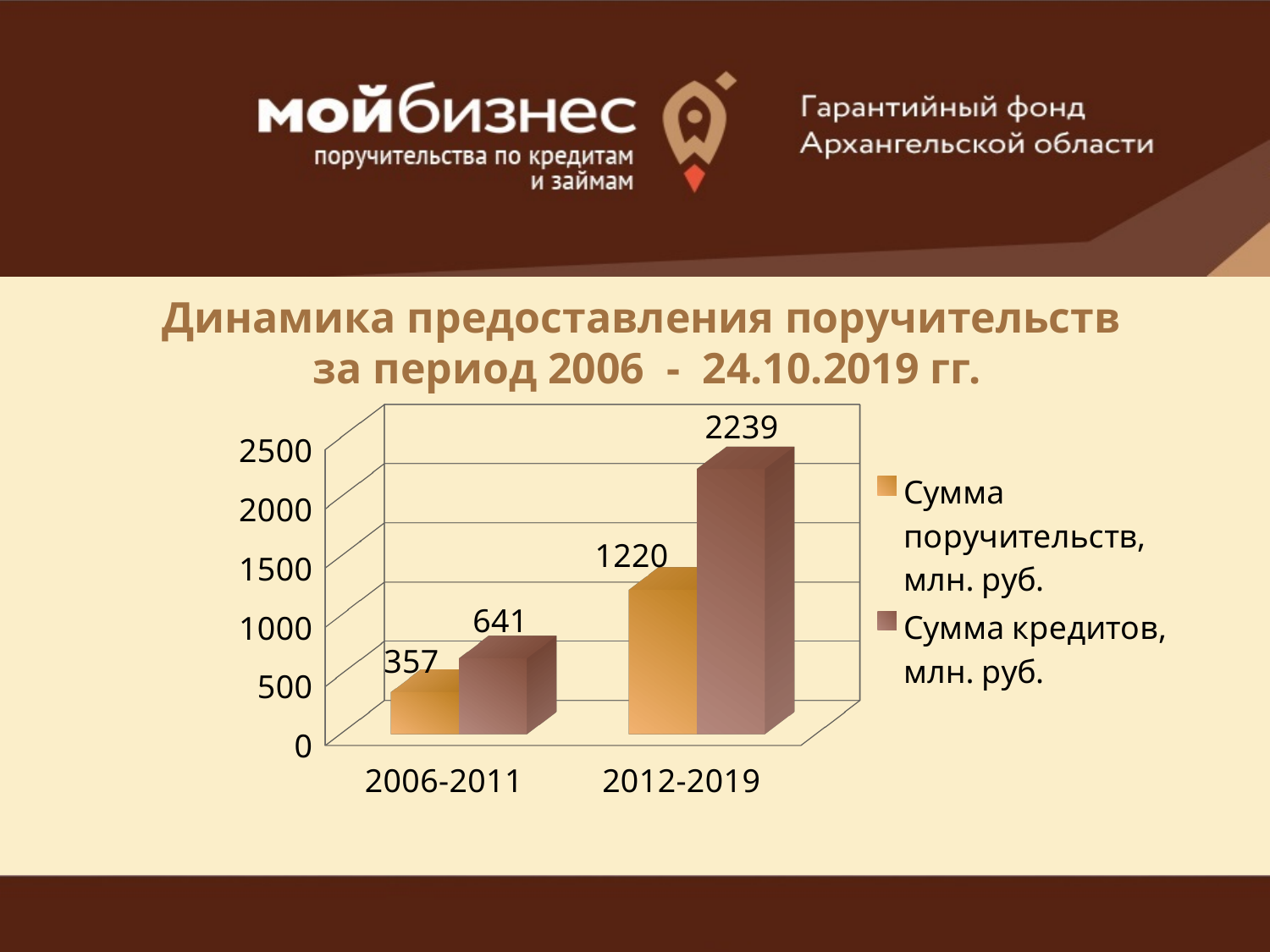
What is the value of "Сумма поручительств, млн. руб." for 2012-2019? 1220 What is the value of "Сумма кредитов, млн. руб." for 2006-2011? 641 What kind of chart is shown on the slide? Bar chart Which period has the highest value for "Сумма кредитов, млн. руб."? 2012-2019 What is the value of "Сумма поручительств, млн. руб." for 2006-2011? 357 How many periods are shown on the x axis? 2 What is the difference between "Сумма кредитов, млн. руб." and "Сумма поручительств, млн. руб." for 2012-2019? 1019 Does "Сумма поручительств, млн. руб." rise or fall from 2006-2011 to 2012-2019? Rise What is the value of "Сумма кредитов, млн. руб." for 2012-2019? 2239 How many series does the legend list? 2 Which period has the lowest value for "Сумма поручительств, млн. руб."? 2006-2011 Which is larger for 2006-2011: "Сумма поручительств, млн. руб." or "Сумма кредитов, млн. руб."? Сумма кредитов, млн. руб.